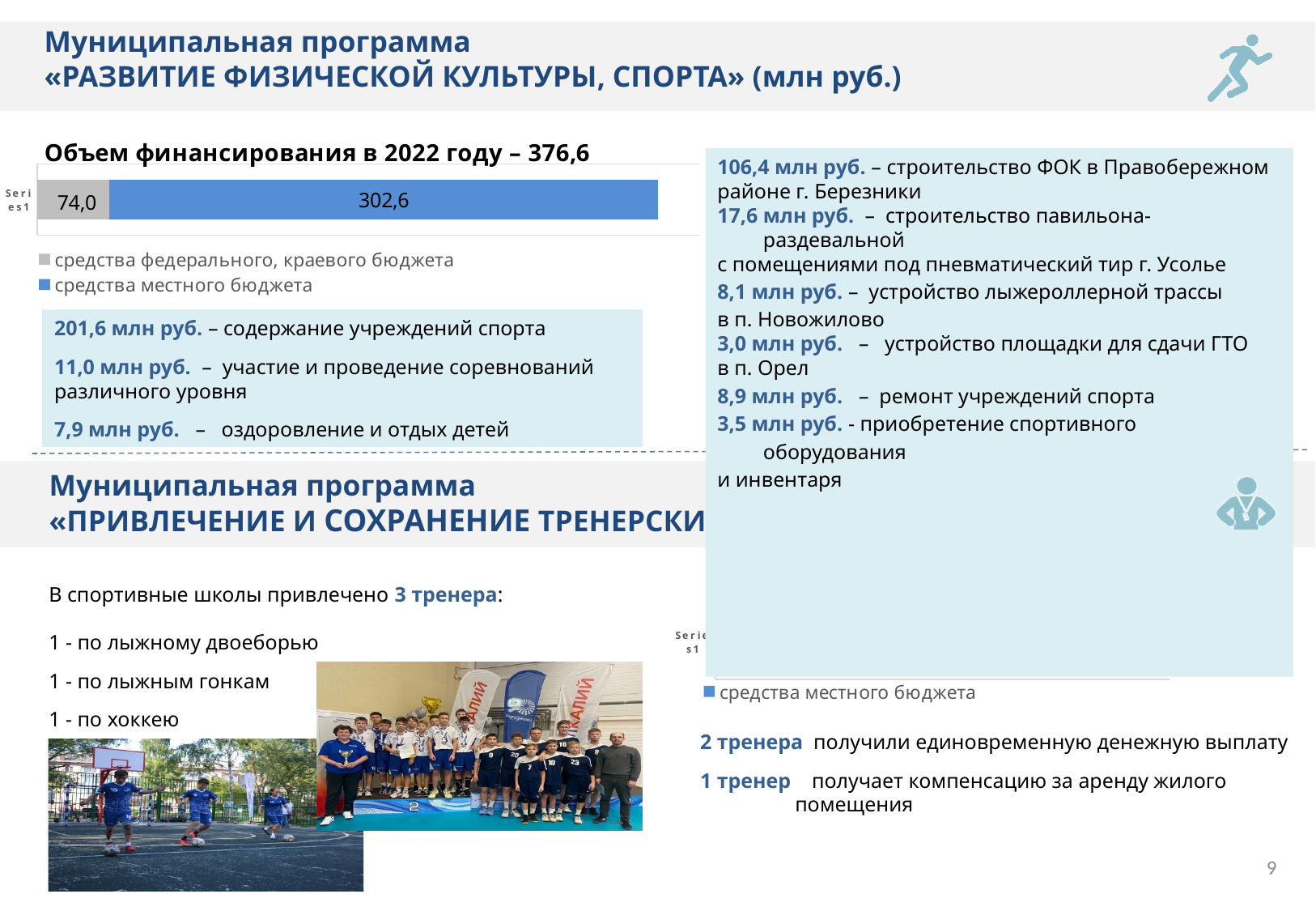
On the top chart, which colour represents средства федерального, краевого бюджета? grey On the top chart, which colour represents средства местного бюджета? blue On the top chart, which series has the larger value: средства местного бюджета or средства федерального, краевого бюджета? средства местного бюджета How many bars does the top chart contain? 1 On the top chart, which series has the smallest value? средства федерального, краевого бюджета On the top chart (Объем финансирования в 2022 году), what is the value for средства федерального, краевого бюджета? 74,0 On the top chart, what is the difference between средства местного бюджета and средства федерального, краевого бюджета? 228,6 On the top chart, what is the total of the stacked bar? 376,6 What kind of chart is the top chart under 'Объем финансирования в 2022 году'? stacked bar chart How many series does the legend of the top chart list? 2 On the top chart (Объем финансирования в 2022 году), what is the value for средства местного бюджета? 302,6